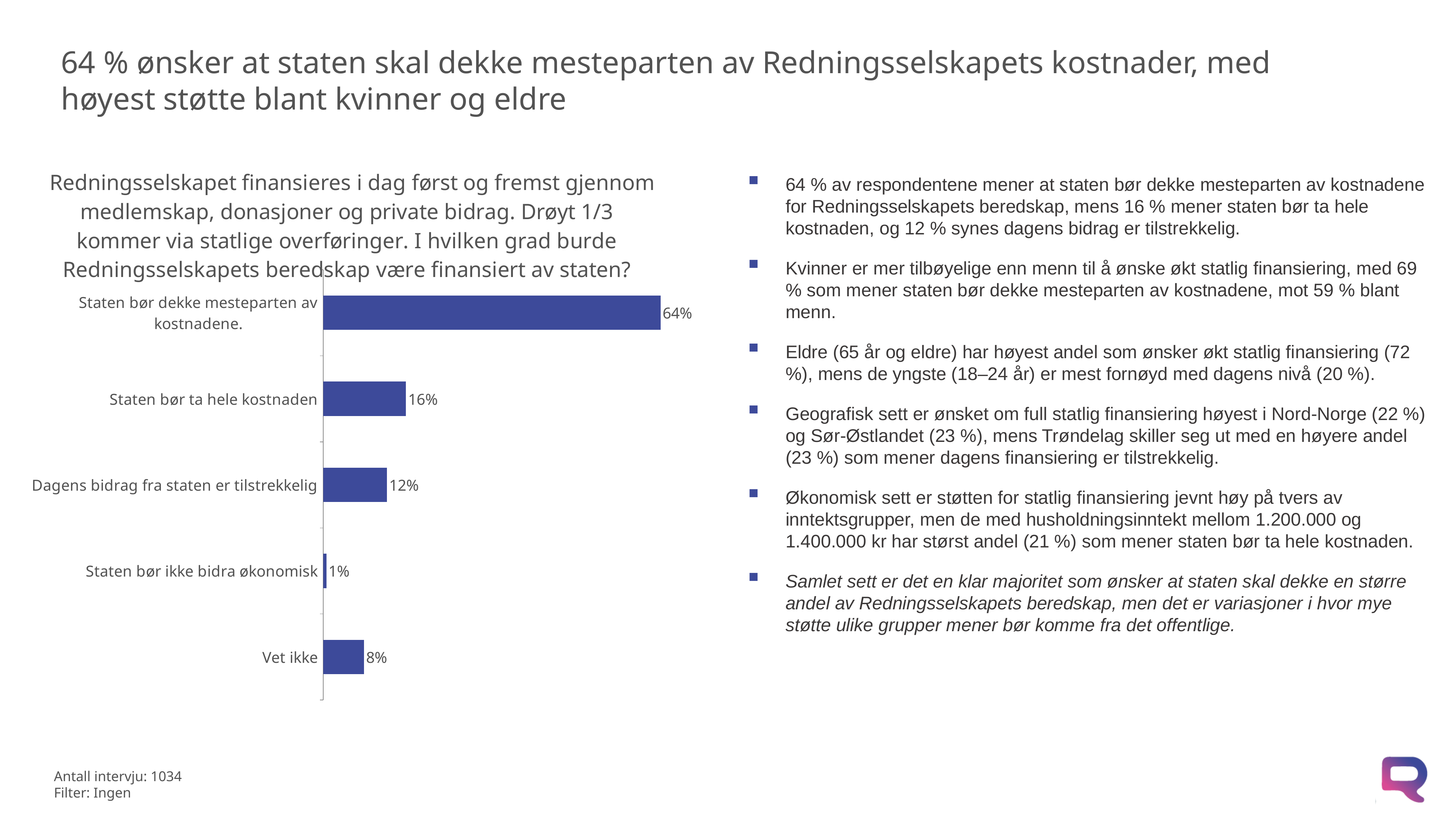
Which is larger, "Vet ikke" or "Staten bør ikke bidra økonomisk"? Vet ikke What kind of chart is shown on the slide? Bar chart What is the difference between the highest and lowest values in the chart? 63% What is the value for "Vet ikke"? 8% What is the value for "Dagens bidrag fra staten er tilstrekkelig"? 12% What is the difference between "Staten bør ta hele kostnaden" and "Dagens bidrag fra staten er tilstrekkelig"? 4% What is the value for "Staten bør ta hele kostnaden"? 16% What is the value for "Staten bør dekke mesteparten av kostnadene."? 64% How many categories are shown in the chart? 5 Which category has the lowest value? Staten bør ikke bidra økonomisk Which category has the highest value? Staten bør dekke mesteparten av kostnadene. What is the number of interviews (Antall intervju) stated on the slide? 1034